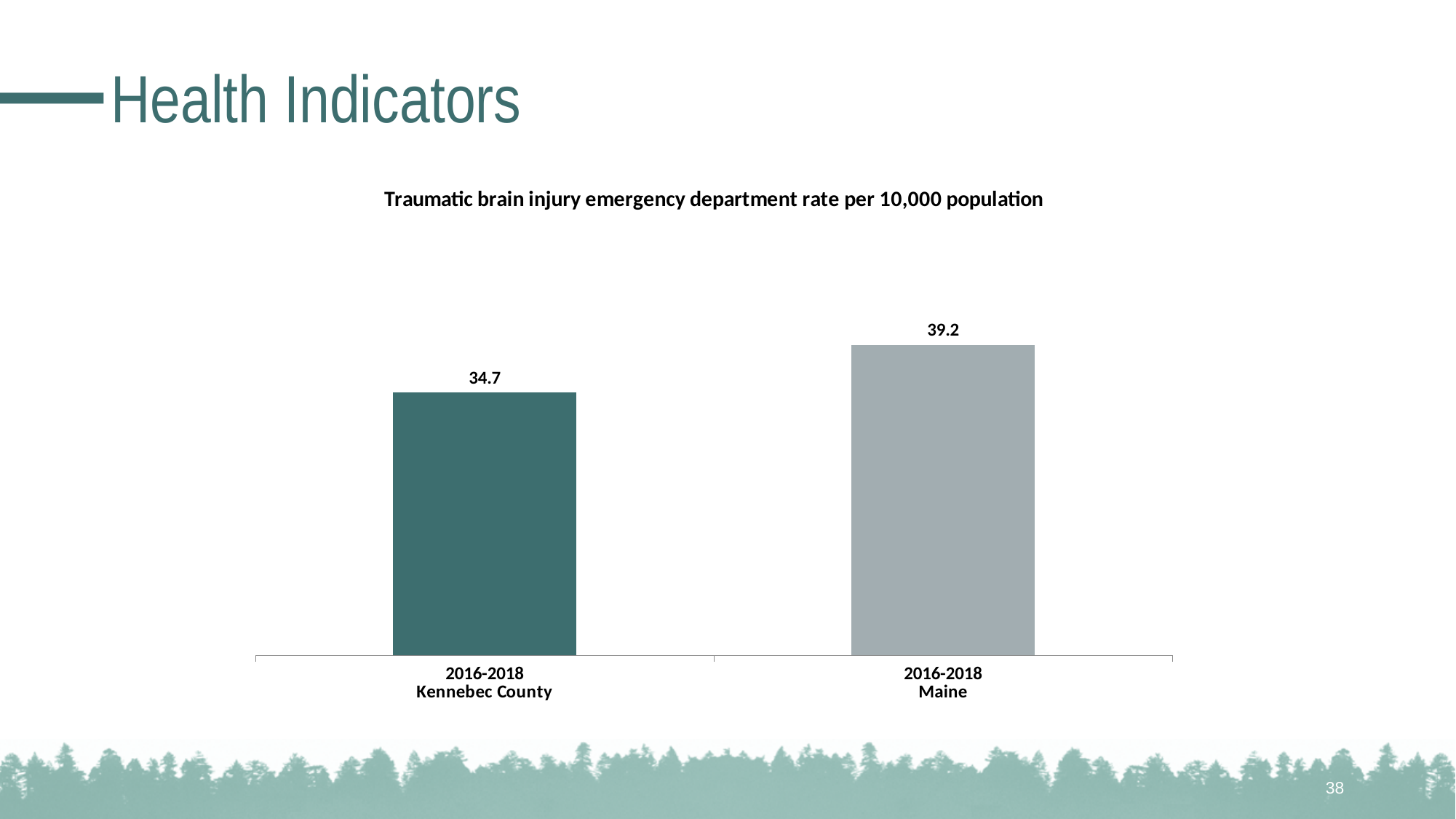
Which category has the lowest traumatic brain injury emergency department rate? Kennebec County What time period do both bars in the chart cover? 2016-2018 What type of chart is shown on the slide? bar chart What is the title of the chart? Traumatic brain injury emergency department rate per 10,000 population How many bars are shown in the chart? 2 What is the traumatic brain injury emergency department rate per 10,000 population for Maine in 2016-2018? 39.2 Is the rate for Kennebec County larger or smaller than the rate for Maine? smaller What is the traumatic brain injury emergency department rate per 10,000 population for Kennebec County in 2016-2018? 34.7 What is the difference between the Maine rate and the Kennebec County rate? 4.5 Which category has the higher traumatic brain injury emergency department rate, Kennebec County or Maine? Maine